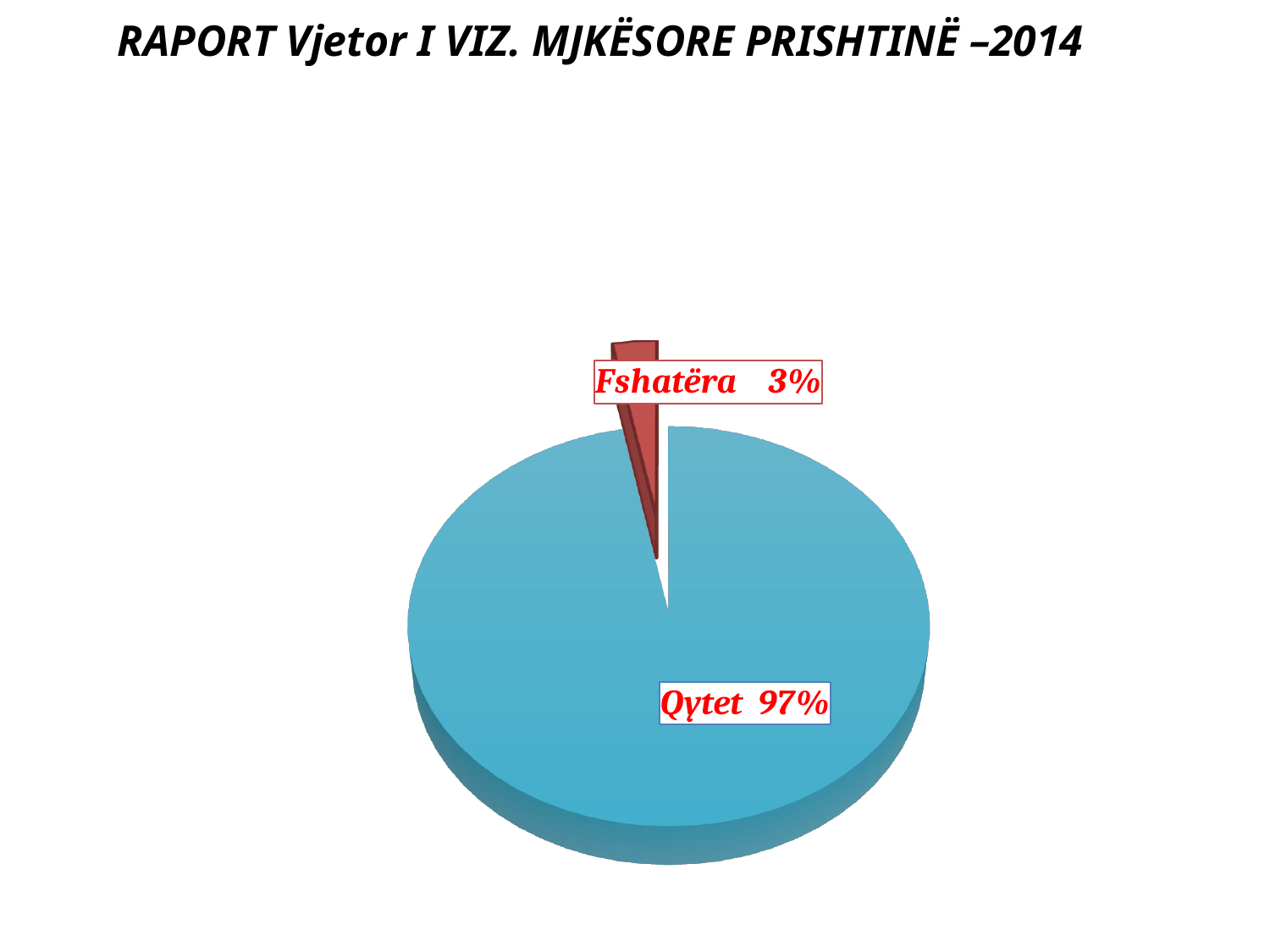
What share of the pie does Fshatëra represent? 3% What share of the pie does Qytet represent? 97% How many slices does the pie chart have? 2 What is the title shown at the top of the slide? RAPORT Vjetor I VIZ. MJKËSORE PRISHTINË –2014 Which is larger, the share for Qytet or the share for Fshatëra? Qytet What is the difference in percentage points between Qytet and Fshatëra? 94 What colour is the Fshatëra slice? red What kind of chart is shown on the slide? pie chart Which slice of the pie is the smallest? Fshatëra Which slice of the pie is the largest? Qytet